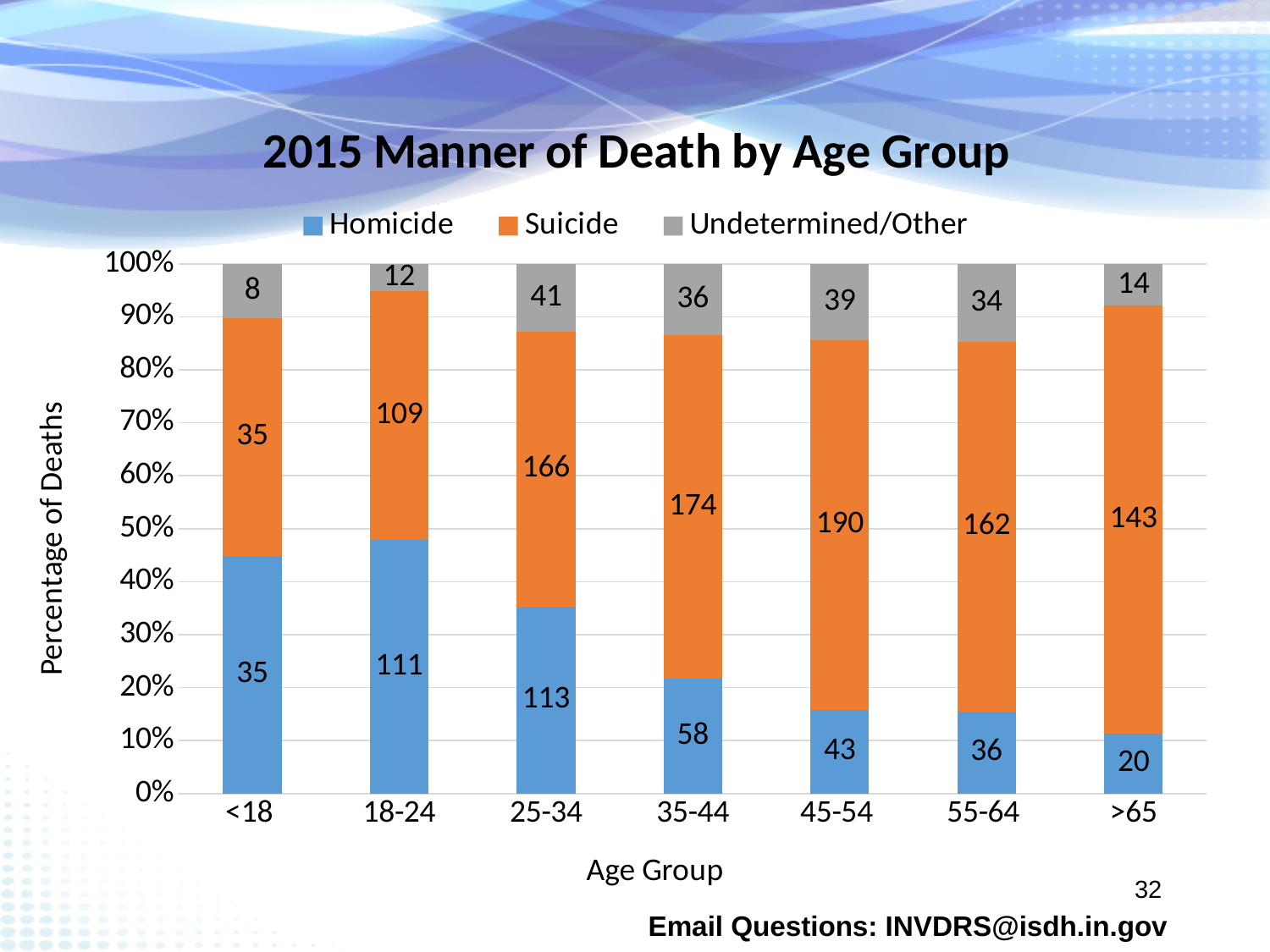
Which is larger for the 18-24 age group, the Homicide count or the Suicide count? Homicide Which age group has the highest Suicide count? 45-54 What is the Homicide count for the 25-34 age group? 113 What is the Undetermined/Other count for the 18-24 age group? 12 Which age group has the lowest Homicide count? >65 What is the Suicide count for the >65 age group? 143 Is the Homicide share of deaths for the 18-24 age group greater or less than 40%? greater What is the total number of deaths for the <18 age group across all three series? 78 How many age groups are shown on the x axis? 7 What is the difference between the Suicide and Homicide counts for the 35-44 age group? 116 What kind of chart is shown on the slide? Stacked bar chart How many series does the legend list? 3